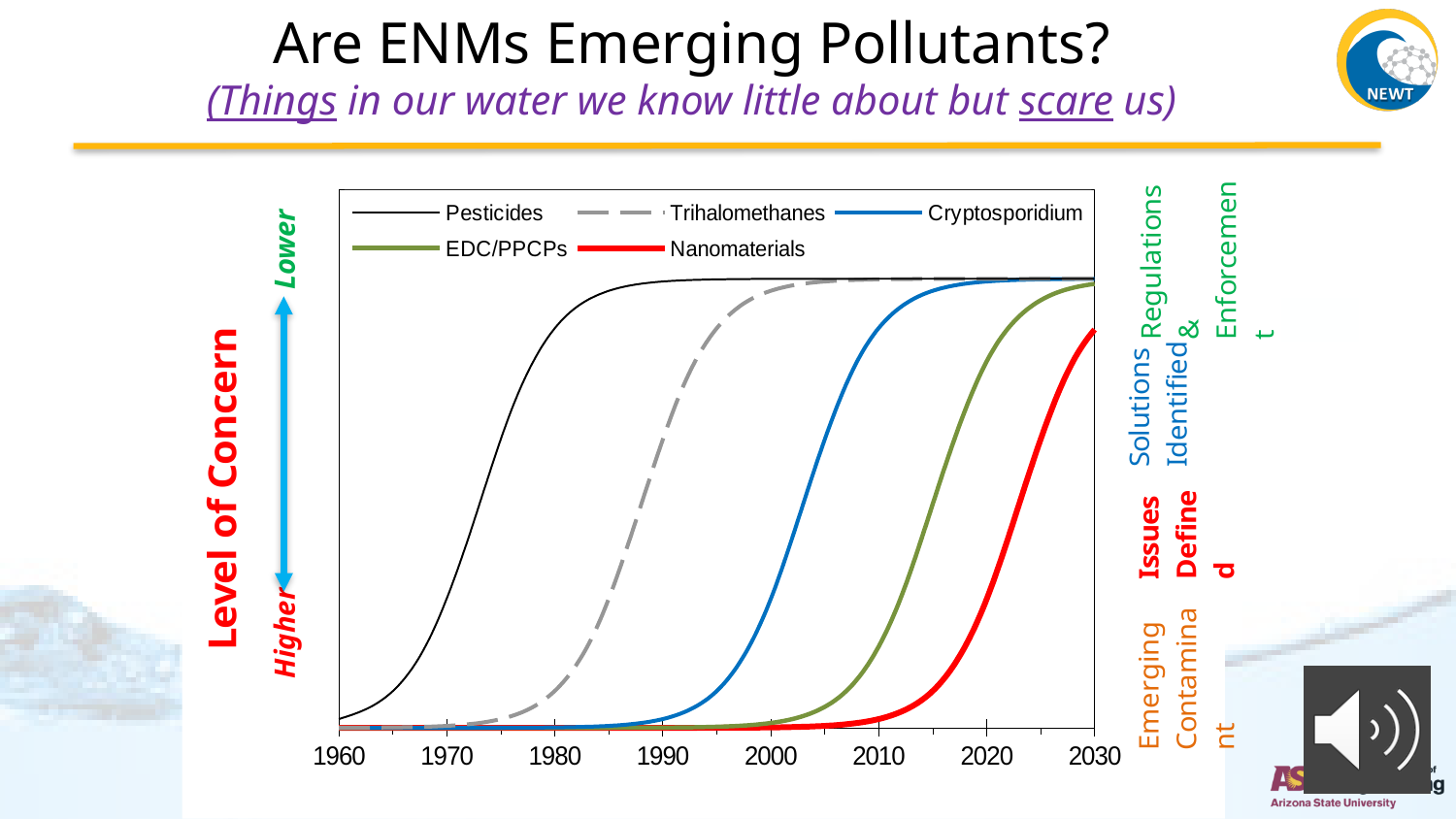
Which series rises earlier, Trihalomethanes or Nanomaterials? Trihalomethanes What kind of chart is shown on the slide? line chart What is the label on the vertical axis of the chart? Level of Concern Which series rises latest along the x axis? Nanomaterials How many series does the legend list? 5 What is the first year shown on the x axis? 1960 Do the plotted curves rise or fall as the years increase along the x axis? rise Which series rises earliest along the x axis? Pesticides What is the last year shown on the x axis? 2030 Which series is drawn as a dashed line? Trihalomethanes Which series rises earlier, Cryptosporidium or EDC/PPCPs? Cryptosporidium How many year labels are shown along the x axis? 8